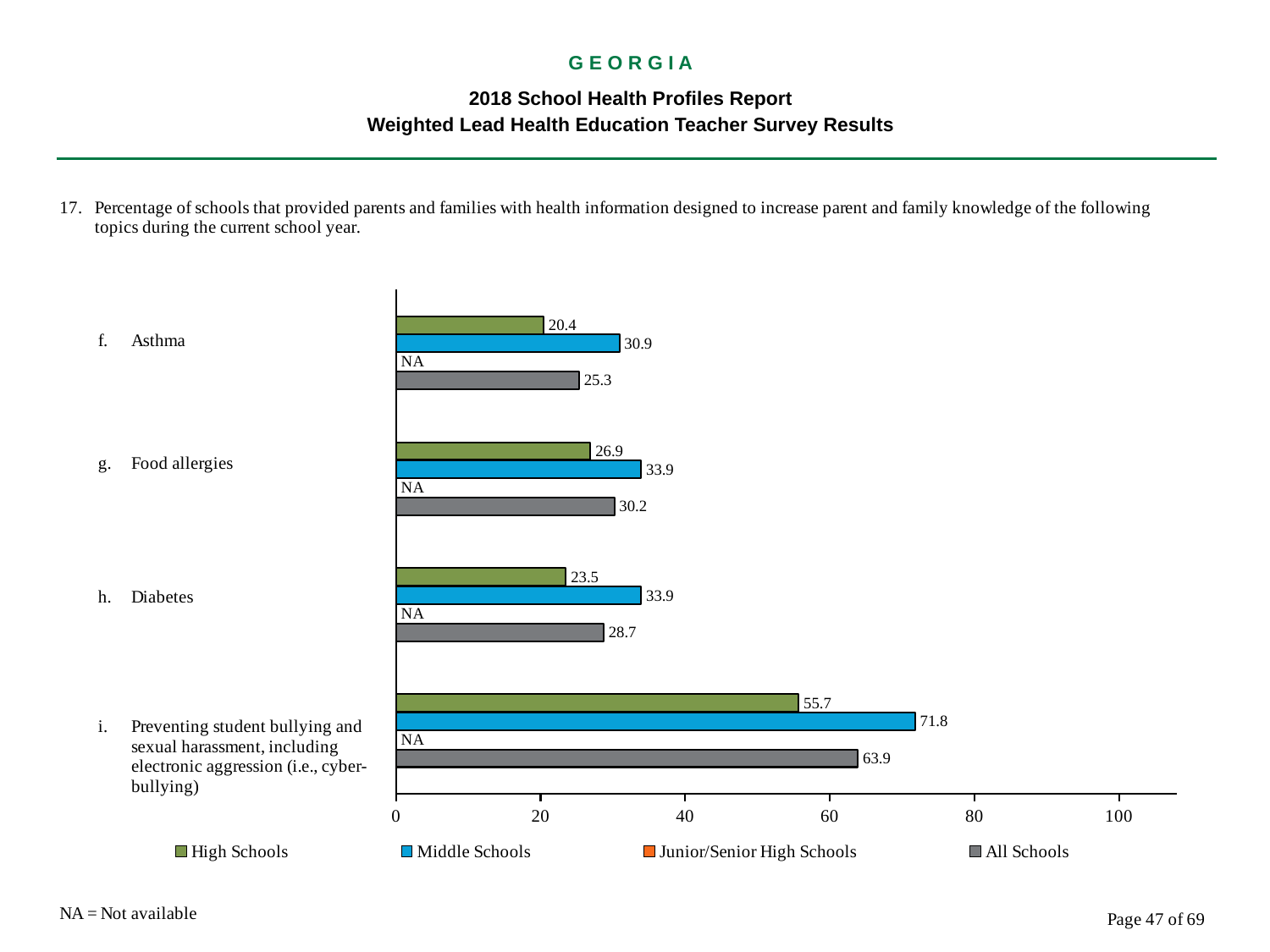
What is the value for All Schools for Diabetes? 28.7 What is the value for High Schools for Food allergies? 26.9 What is the value for Middle Schools for Asthma? 30.9 Is the All Schools value for Preventing student bullying and sexual harassment greater or less than 60? greater Which topic has the highest value for High Schools? Preventing student bullying and sexual harassment, including electronic aggression (i.e., cyber-bullying) What is the difference between the Middle Schools and High Schools values for Preventing student bullying and sexual harassment? 16.1 How many series does the legend list? 4 How many topics are shown on the chart? 4 What kind of chart is shown on the slide? bar chart Which topic has the lowest value for All Schools? Asthma What is the value for Middle Schools for Preventing student bullying and sexual harassment? 71.8 Which is larger for Diabetes: the High Schools value or the Middle Schools value? Middle Schools